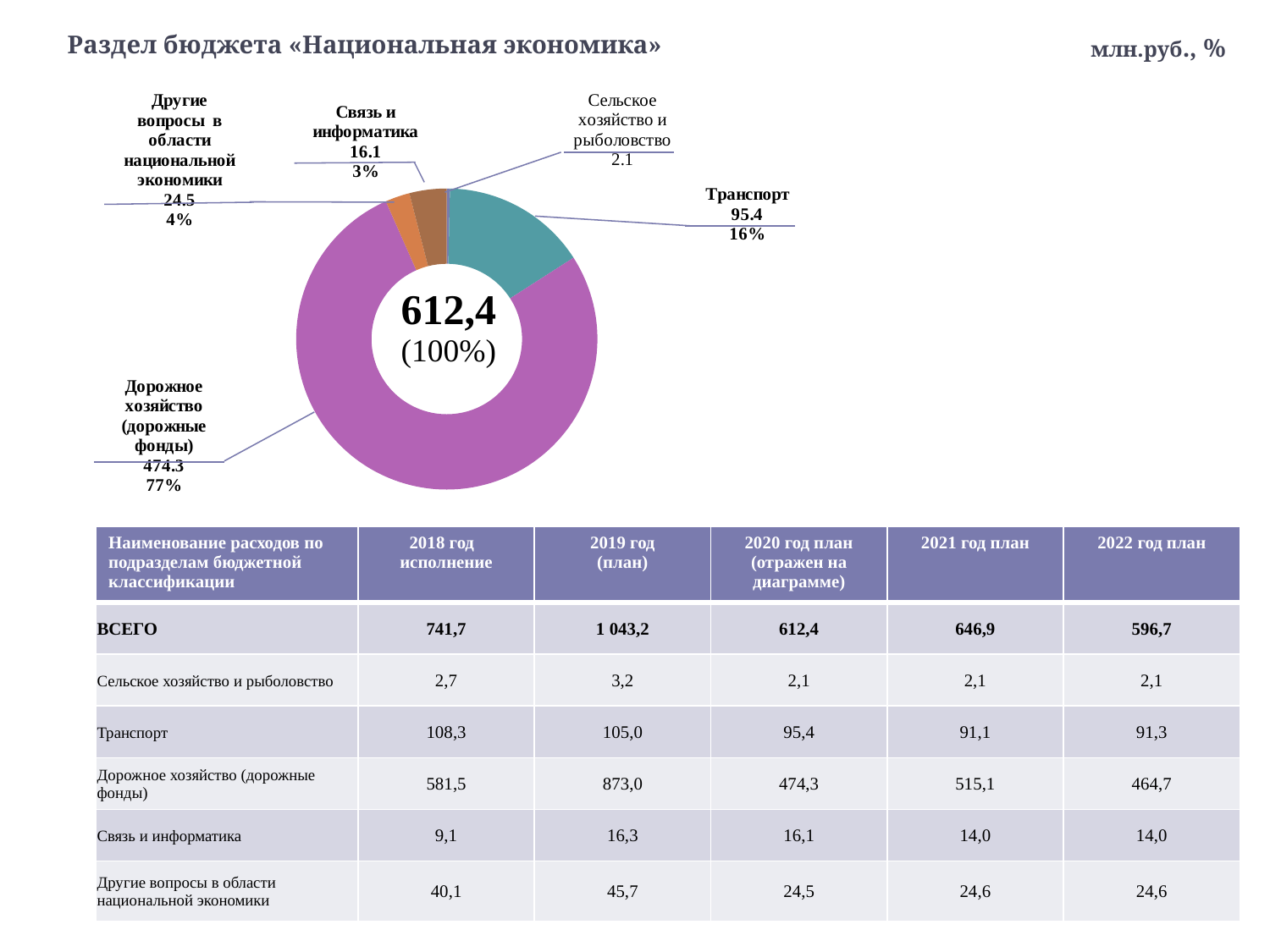
Which category has the largest slice in the chart? Дорожное хозяйство (дорожные фонды) What total value is shown in the centre of the chart? 612,4 Which is larger in the chart, Транспорт or Другие вопросы в области национальной экономики? Транспорт What is the value for Сельское хозяйство и рыболовство in the chart? 2.1 What kind of chart is shown on the slide? Pie (donut) chart What is the value for Дорожное хозяйство (дорожные фонды) in the chart? 474.3 What is the value for Связь и информатика in the chart? 16.1 What is the value for Транспорт in the chart? 95.4 What share of the chart does Дорожное хозяйство (дорожные фонды) represent? 77% What share of the chart does Транспорт represent? 16% How many categories are shown in the chart? 5 Which category has the smallest slice in the chart? Сельское хозяйство и рыболовство